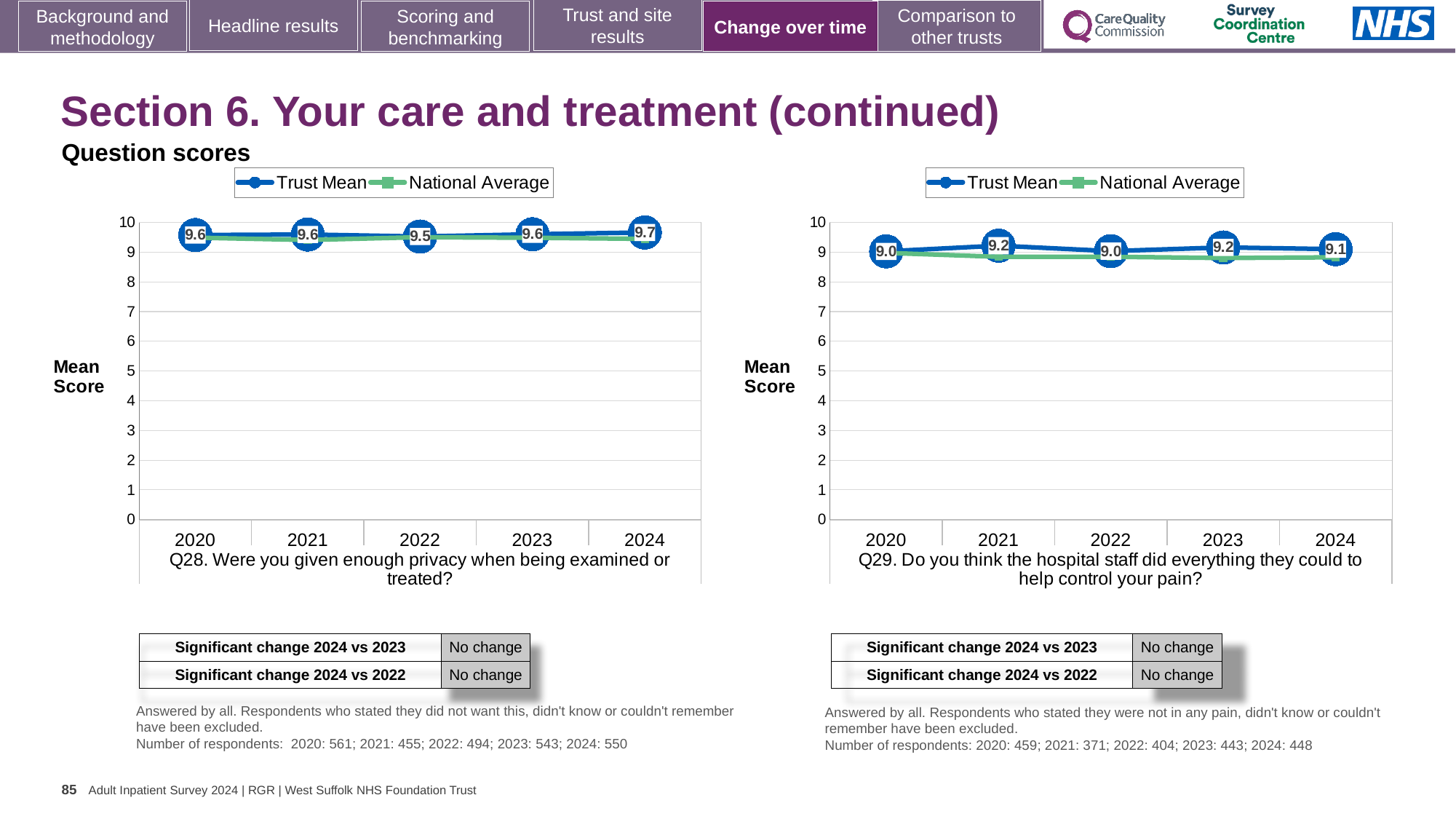
In the Q29 chart (right), what is the Trust Mean score for 2021? 9.2 In the Q29 chart (right), is the Trust Mean score for 2023 larger or smaller than the score for 2024? larger In the Q28 chart (left), what is the Trust Mean score for 2024? 9.7 In the Q28 chart (left), which year has the lowest Trust Mean score? 2022 In the Q29 chart (right), what is the Trust Mean score for 2024? 9.1 How many years are plotted on the x axis of the Q29 chart (right)? 5 In the Q29 chart (right), what is the difference between the Trust Mean scores for 2021 and 2020? 0.2 In the Q28 chart (left), is the Trust Mean value for 2020 greater or less than 9? greater In the Q28 chart (left), what is the Trust Mean score for 2022? 9.5 In the Q28 chart (left), which year has the highest Trust Mean score? 2024 How many series does the legend of the Q28 chart (left) list? 2 What type of chart is used for Q28 (left)? Line chart